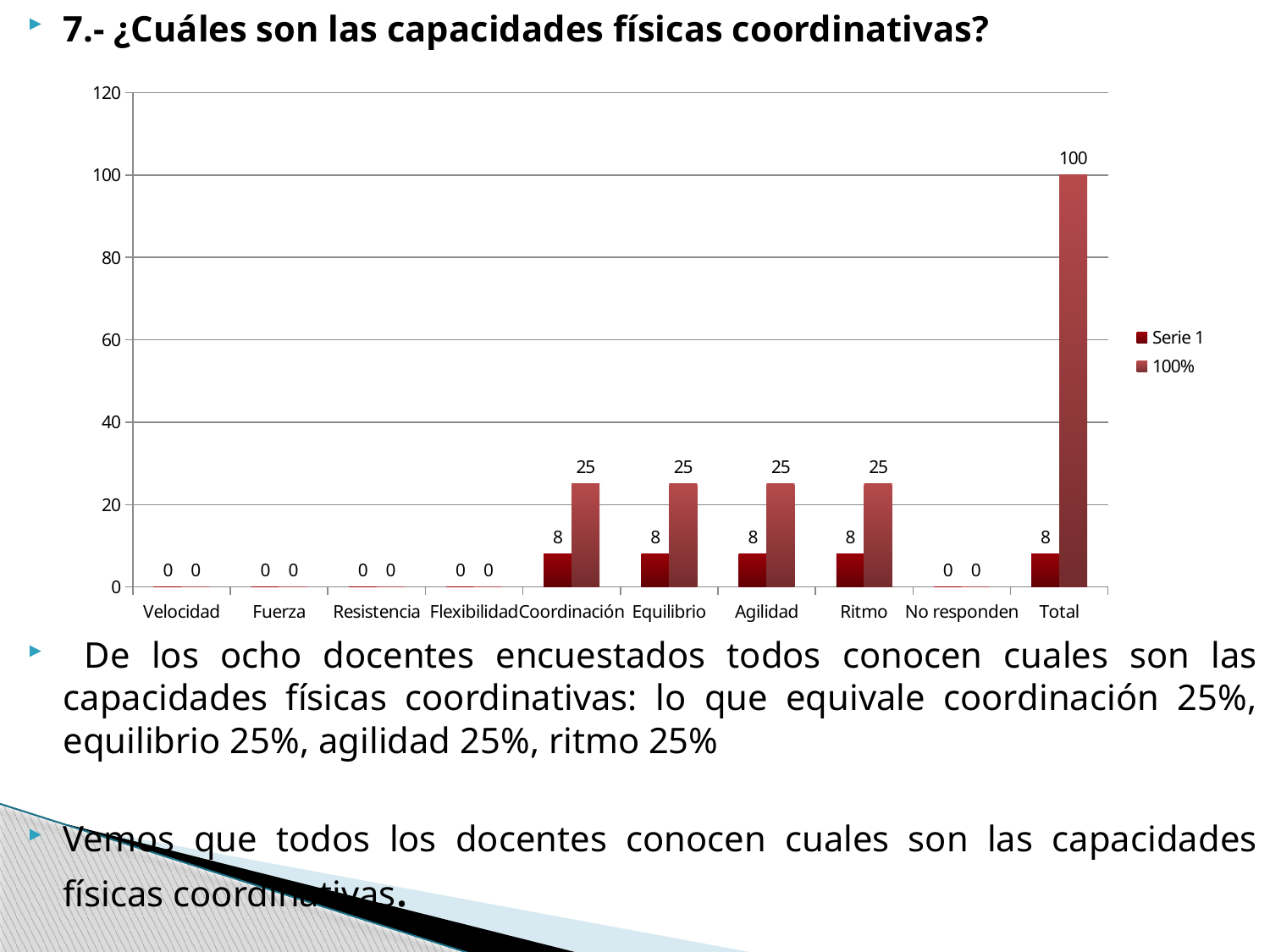
Which is larger: the 100% series value for Equilibrio or for Fuerza? Equilibrio What is the value of the 100% series for Coordinación? 25 How many categories are shown on the x axis? 10 What is the value of the 100% series for Total? 100 What is the value of Serie 1 for Total? 8 How many series does the legend list? 2 What is the difference between the 100% series value for Total and for Ritmo? 75 What is the value of Serie 1 for Velocidad? 0 Which category has the highest value in the 100% series? Total What kind of chart is shown on the slide? bar chart Is the 100% series value for Total greater or less than 80? greater What are the two legend entries of the chart? Serie 1 and 100%